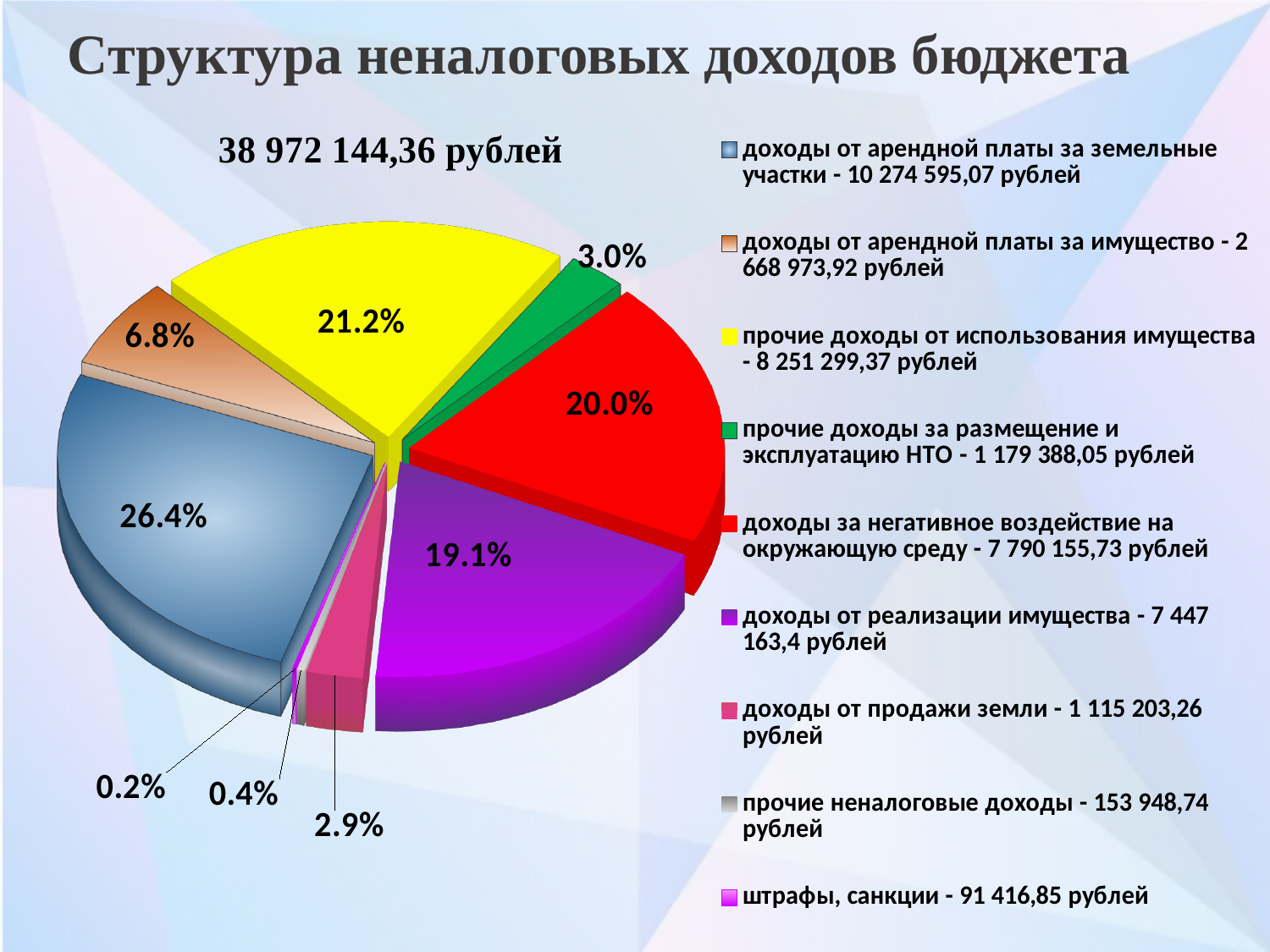
Which is larger: the share for 'доходы за негативное воздействие на окружающую среду' or the share for 'доходы от реализации имущества'? доходы за негативное воздействие на окружающую среду Which category has the smallest share of the pie? штрафы, санкции How many slices does the pie chart have? 9 What is the value for 'прочие доходы от использования имущества' according to the legend? 8 251 299,37 рублей What share of the pie is 'доходы от реализации имущества'? 19.1% What is the value for 'штрафы, санкции' according to the legend? 91 416,85 рублей Which category has the largest share of the pie? доходы от арендной платы за земельные участки What share of the pie is 'доходы от арендной платы за земельные участки'? 26.4% What is the title of the chart on the slide? Структура неналоговых доходов бюджета What total amount is shown above the pie chart? 38 972 144,36 рублей What is the difference in percentage points between the share for 'доходы от арендной платы за земельные участки' (26.4%) and the share for 'прочие доходы от использования имущества' (21.2%)? 5.2% What kind of chart is shown on the slide? Pie chart